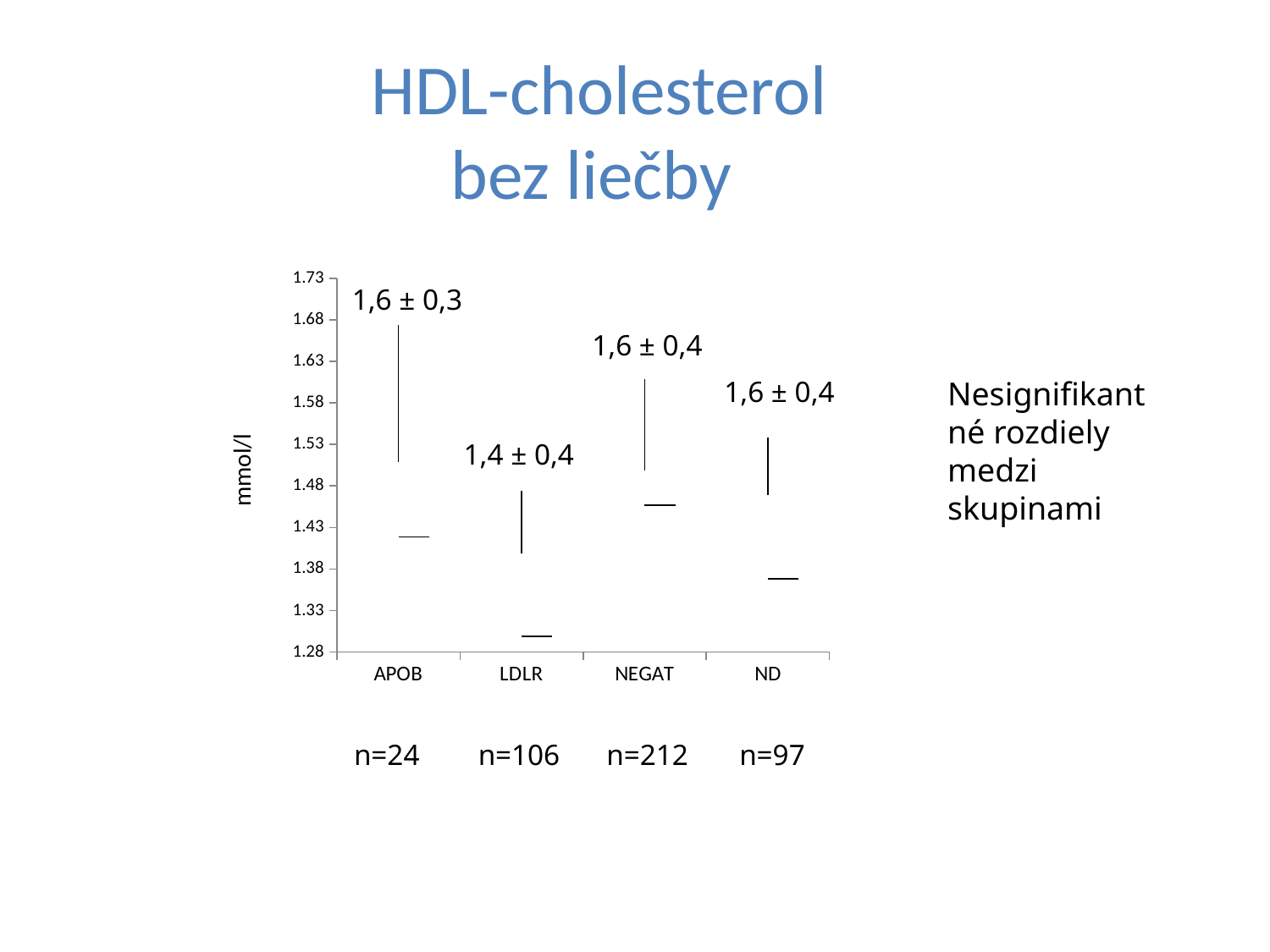
What value label is printed above the NEGAT group? 1,6 ± 0,4 Is the horizontal marker for ND greater or less than 1.43? less What unit is shown on the y axis of the chart? mmol/l What value label is printed above the APOB group? 1,6 ± 0,3 Which group has the lowest horizontal marker on the chart? LDLR Is the horizontal marker for APOB greater or less than 1.48? less Which group has the largest sample size (n)? NEGAT What value label is printed above the LDLR group? 1,4 ± 0,4 How many categories are shown on the x axis of the chart? 4 Which group has the smallest sample size (n)? APOB What sample size (n) is given for the APOB group? n=24 What sample size (n) is given for the NEGAT group? n=212